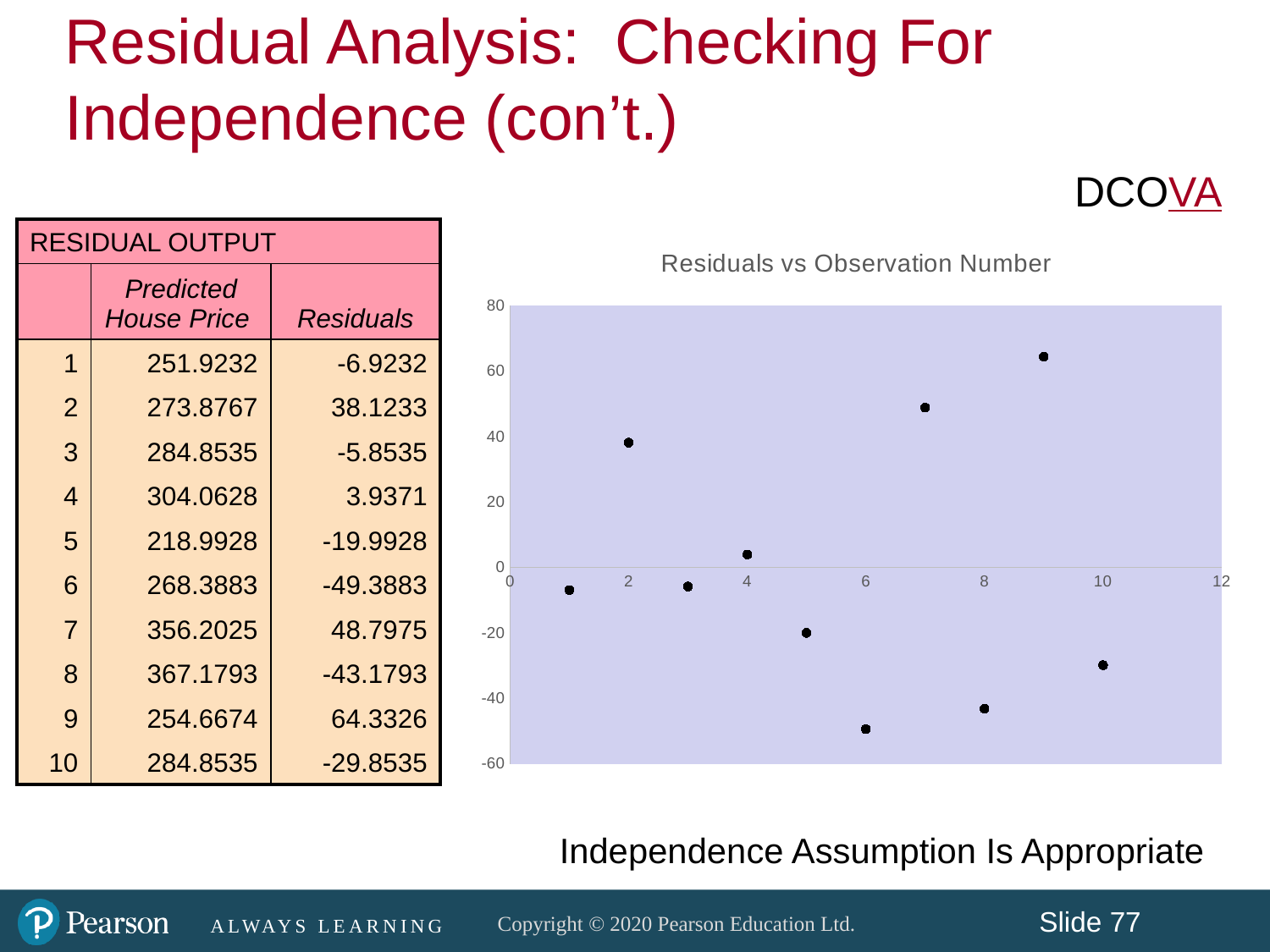
What is the title of the chart on the slide? Residuals vs Observation Number Which observation number has the lowest residual in the chart? 6 Which observation number has the highest residual in the chart? 9 What kind of chart is shown on the slide? scatter chart Is the residual for observation 2 greater or less than 20? greater Is the residual for observation 6 greater or less than -40? less According to the residual output table, what is the residual for observation 6? -49.3883 According to the residual output table, what is the residual for observation 9? 64.3326 Which has the larger residual, observation 7 or observation 2? observation 7 Is the residual for observation 9 greater or less than 60? greater What is the maximum value shown on the vertical axis of the chart? 80 How many data points are plotted in the Residuals vs Observation Number chart? 10